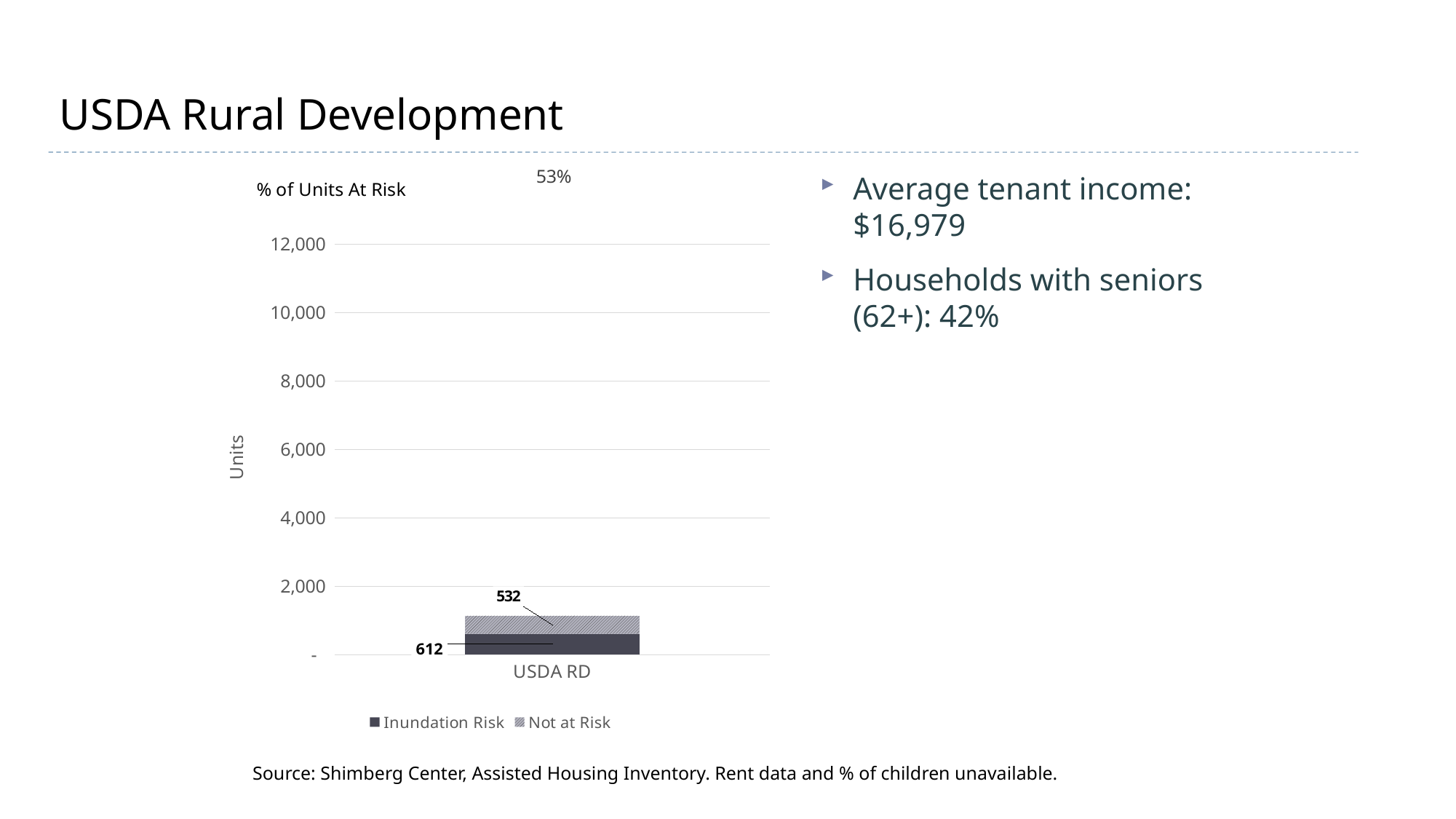
How many series does the legend list? 2 Is the total of the USDA RD bar greater or less than 2,000? less What is the label of the y axis? Units Which is larger for USDA RD, Inundation Risk or Not at Risk? Inundation Risk What is the total of the stacked bar for USDA RD? 1,144 What is the value for Not at Risk for USDA RD? 532 What is the value for Inundation Risk for USDA RD? 612 What is the difference between the Inundation Risk and Not at Risk values for USDA RD? 80 How many categories are shown on the x axis? 1 What kind of chart is shown? stacked bar chart What percentage of units at risk is shown above the chart? 53%